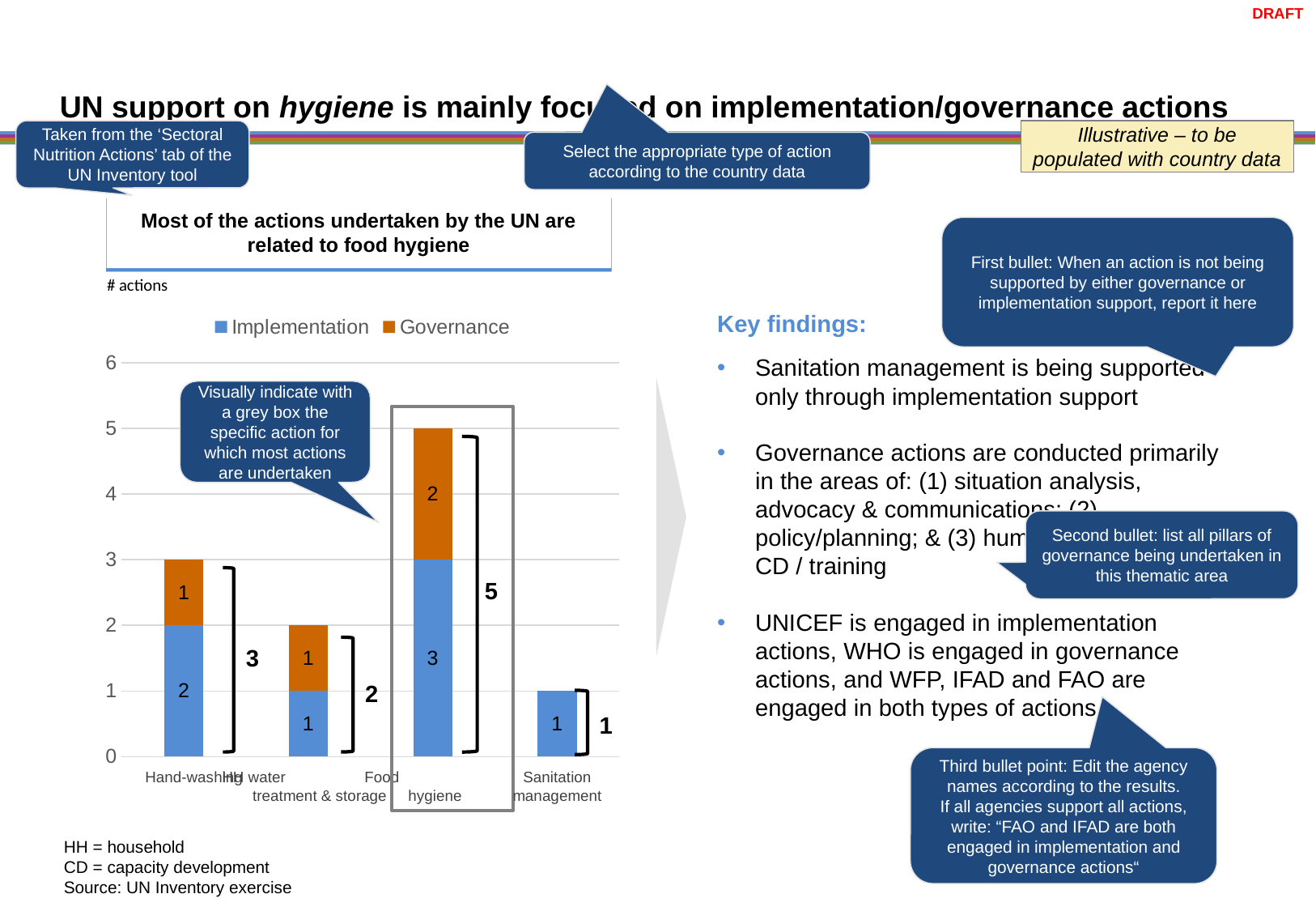
What type of chart is shown on the slide? Stacked bar chart What is the total number of actions for Food hygiene? 5 What is the total number of actions for HH water treatment & storage? 2 What is the difference between the total actions for Food hygiene and Hand-washing? 2 Which series is shown in orange in the chart legend? Governance How many categories are shown on the x axis of the chart? 4 What is the Governance value for Hand-washing? 1 What is the Implementation value for Sanitation management? 1 Which category has the lowest total number of actions? Sanitation management How many series does the chart legend list? 2 What is the Implementation value for Food hygiene? 3 Which category has the highest total number of actions? Food hygiene